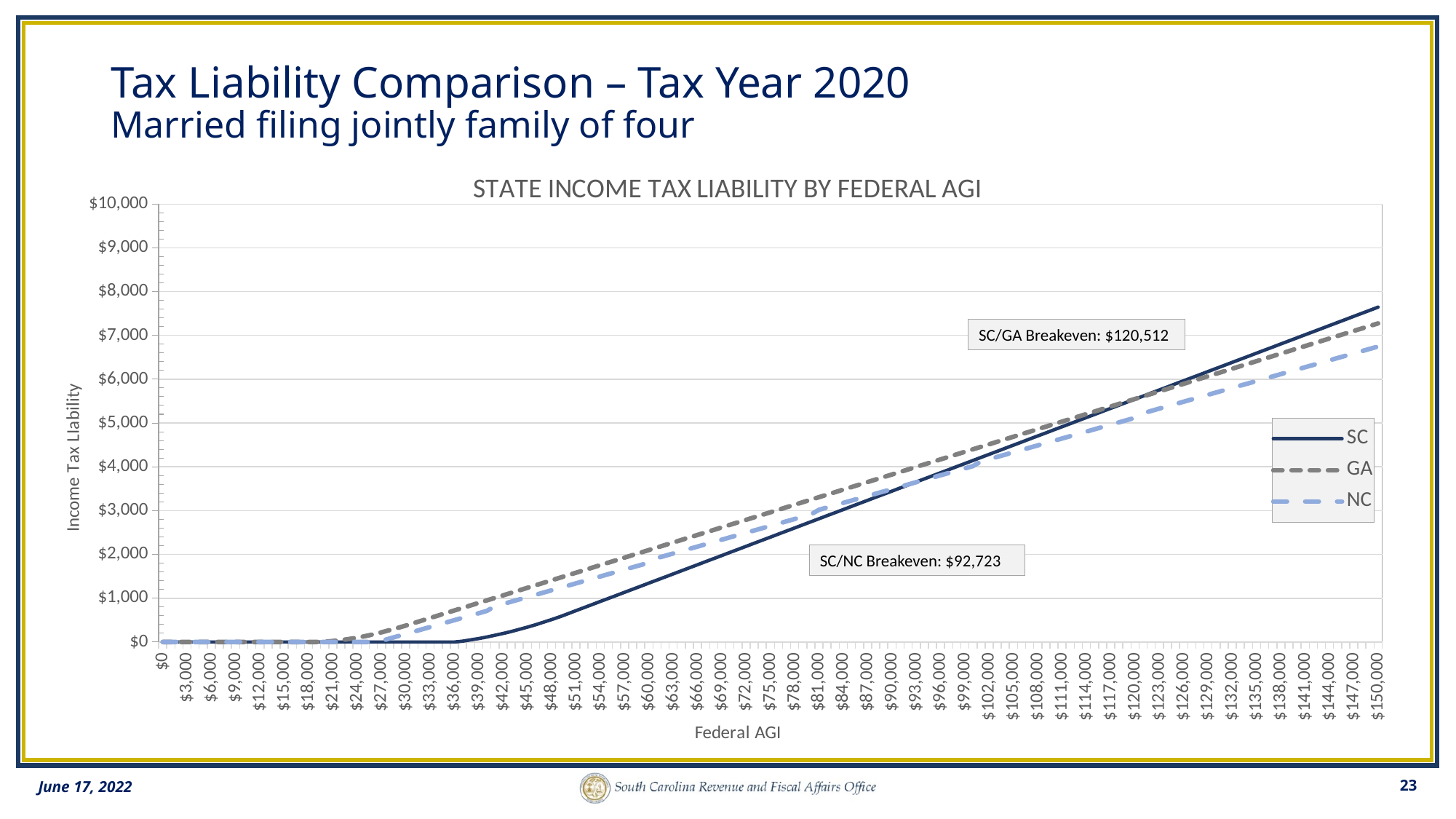
Is the SC income tax liability at a federal AGI of $30,000 greater or less than $1,000? less At what federal AGI does the chart say SC and GA break even? $120,512 How many series does the chart legend list? 3 Which series has the highest income tax liability at a federal AGI of $150,000? SC At what federal AGI does the chart say SC and NC break even? $92,723 What kind of chart is shown on the slide? Line chart Which series are listed in the chart legend? SC, GA, NC Which series has the lowest income tax liability at a federal AGI of $150,000? NC At a federal AGI of $60,000, is the income tax liability higher for GA or for SC? GA Which series has the lowest income tax liability at a federal AGI of $60,000? SC What is the title of the chart? STATE INCOME TAX LIABILITY BY FEDERAL AGI Is the SC income tax liability at a federal AGI of $150,000 greater or less than $7,000? greater